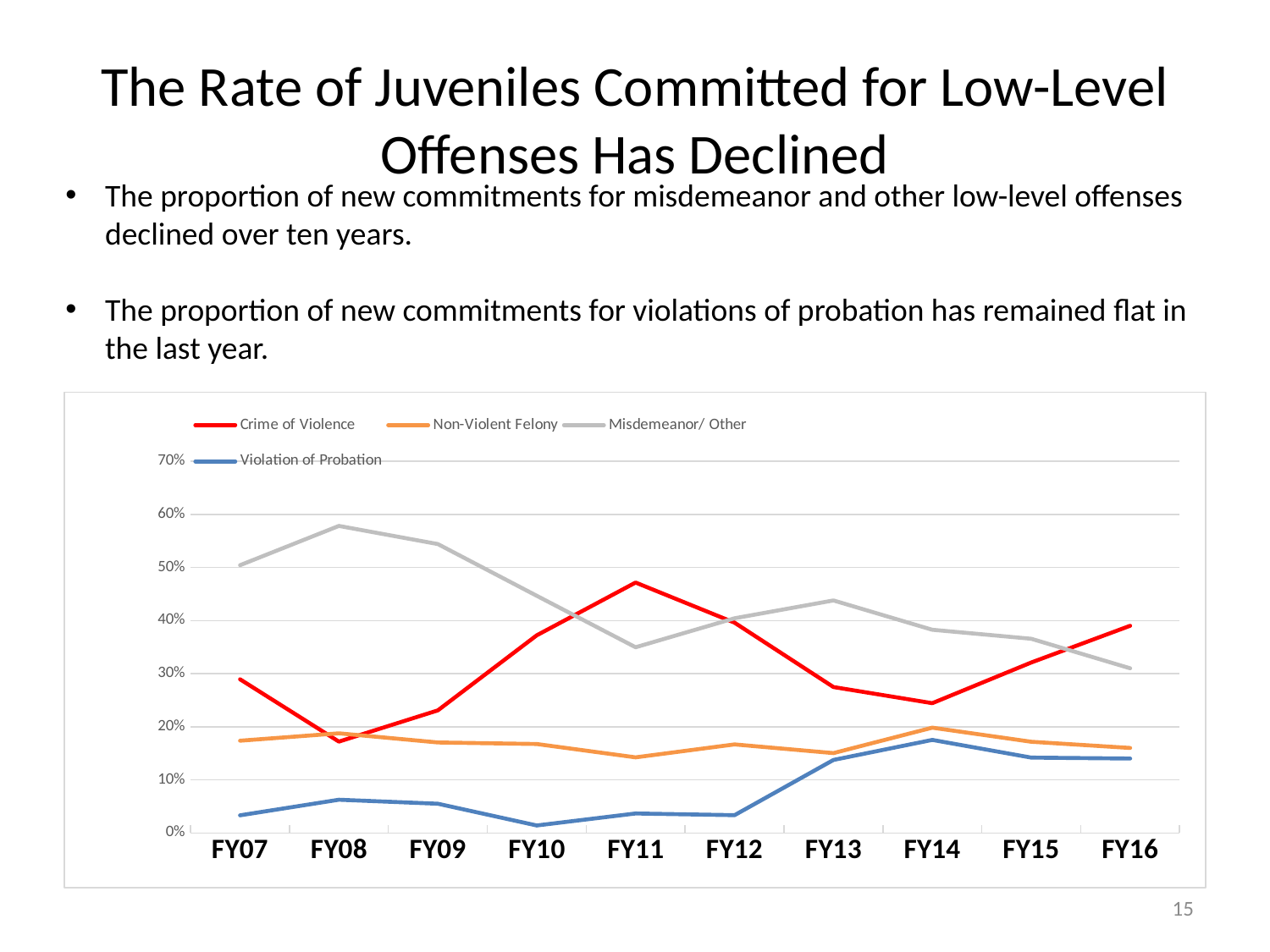
How many series does the chart's legend list? 4 Is the value for Violation of Probation in FY10 greater or less than 10%? less What kind of chart is shown on the slide? Line chart Is the value for Misdemeanor/ Other in FY16 greater or less than 40%? less In which fiscal year does the Crime of Violence line reach its highest value? FY11 Does the Misdemeanor/ Other line rise or fall from FY08 to FY16? Fall In FY11, which is larger: Crime of Violence or Misdemeanor/ Other? Crime of Violence Is the value for Misdemeanor/ Other in FY08 greater or less than 50%? greater Which series has the lowest value in FY07? Violation of Probation How many fiscal years are plotted along the x axis of the chart? 10 In which fiscal year does the Misdemeanor/ Other line reach its highest value? FY08